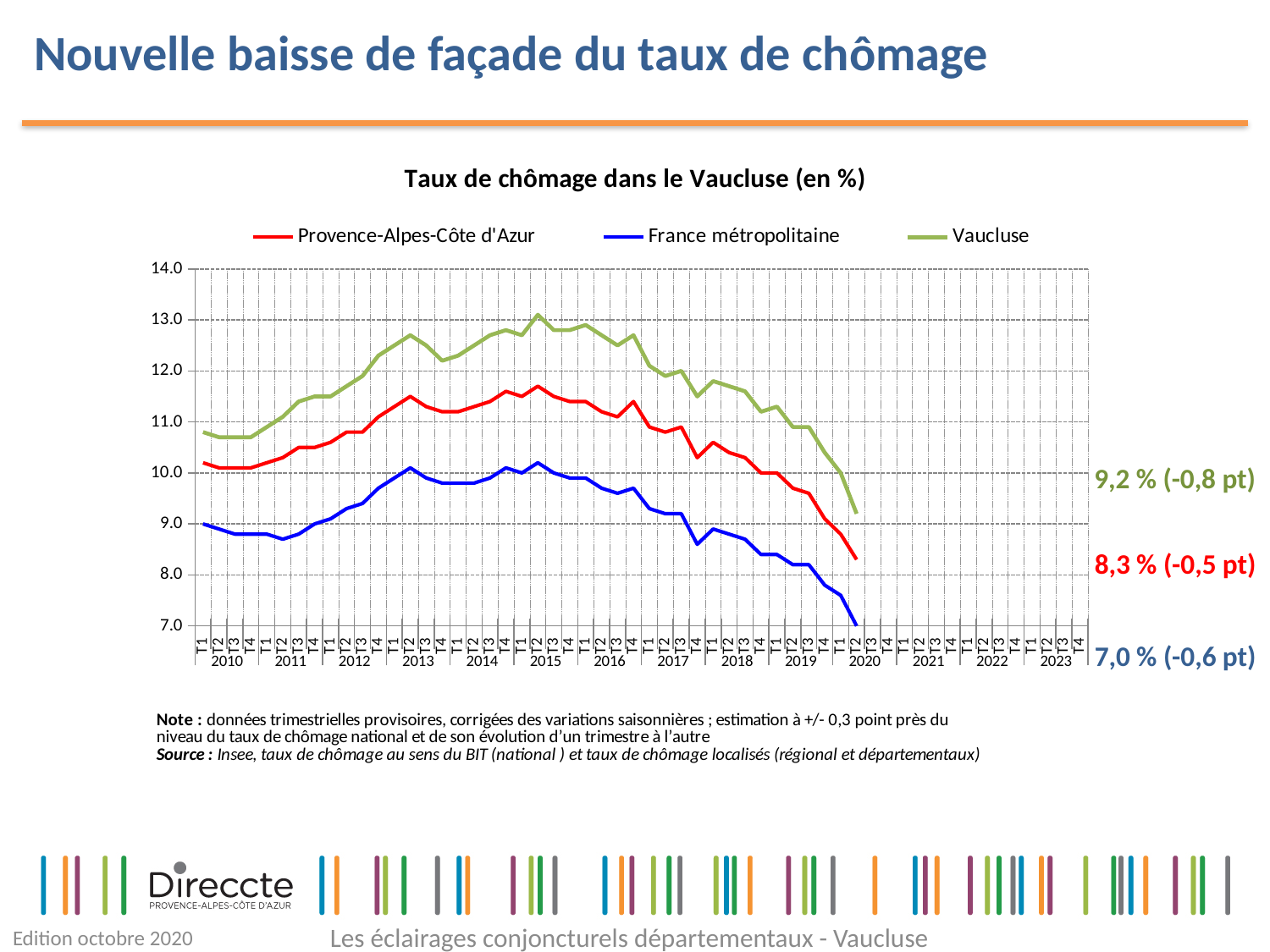
What is the latest value shown for Provence-Alpes-Côte d'Azur? 8,3 % By how many points did the Vaucluse rate change in the latest quarter, according to the annotation? -0,8 pt How many series does the legend list? 3 What is the latest value shown for France métropolitaine? 7,0 % Which series has the highest values across the whole period? Vaucluse What is the title of the chart? Taux de chômage dans le Vaucluse (en %) What kind of chart is shown on the slide? line chart What is the difference between the latest Vaucluse value and the latest Provence-Alpes-Côte d'Azur value? 0,9 pt What is the latest value shown for Vaucluse? 9,2 % Which series has the lowest values across the whole period? France métropolitaine Do the values for all three series rise or fall between 2015 and 2020? fall Is the value for Vaucluse in T1 2010 greater or less than 10.0? greater